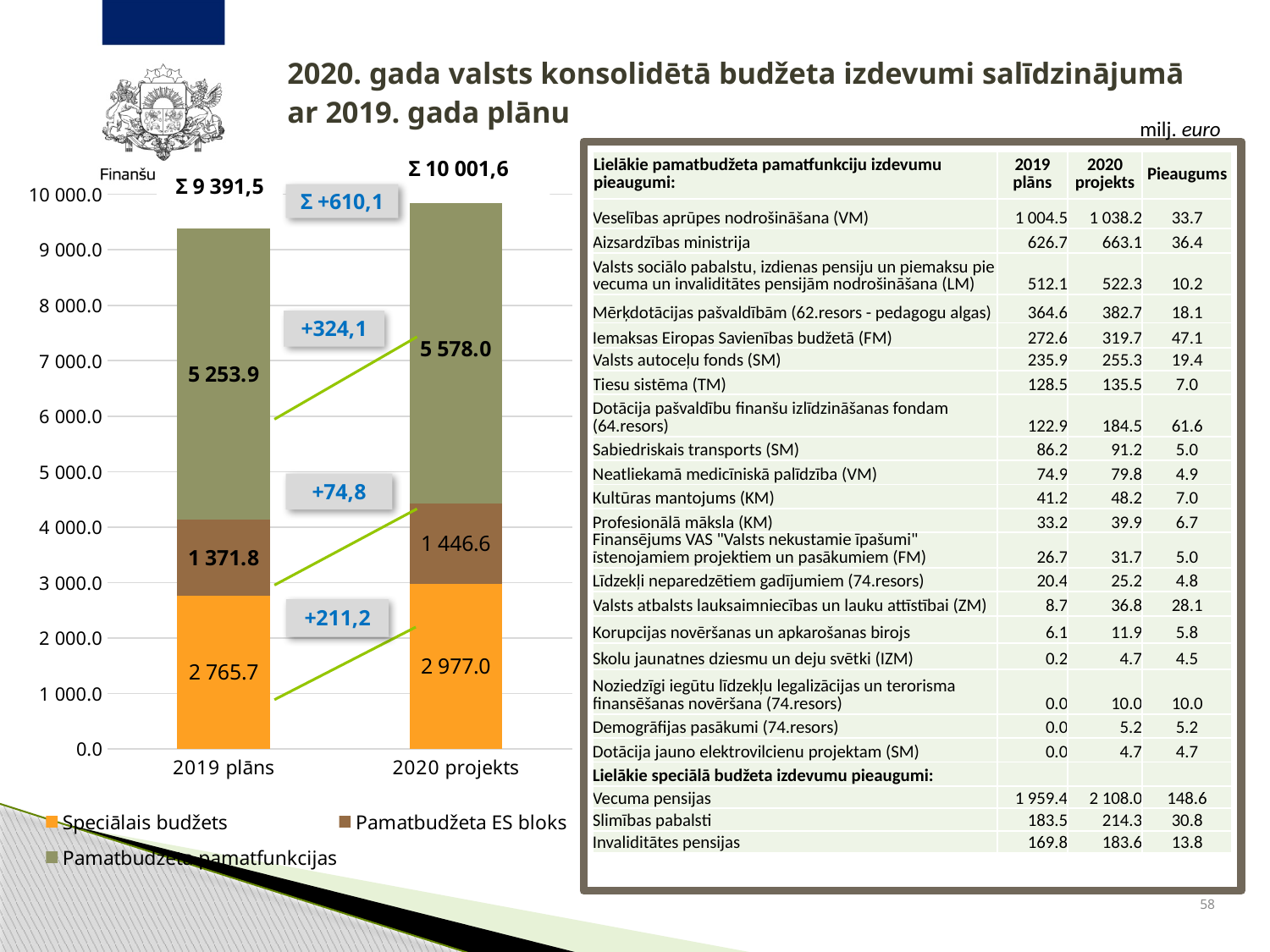
Which series has the largest value in the 2020 projekts bar? Pamatbudžeta pamatfunkcijas Which series is shown in orange in the chart? Speciālais budžets What is the value of Pamatbudžeta pamatfunkcijas for 2020 projekts? 5 578.0 By how much does Speciālais budžets increase from 2019 plāns to 2020 projekts? +211,2 How many series does the chart legend list? 3 What is the value of Pamatbudžeta ES bloks for 2019 plāns? 1 371.8 Which is larger: Pamatbudžeta ES bloks for 2019 plāns or for 2020 projekts? 2020 projekts What is the value of Speciālais budžets for 2019 plāns? 2 765.7 What type of chart is shown on the slide? stacked bar chart What is the total of the stacked bar for 2020 projekts? Σ 10 001,6 What is the total of the stacked bar for 2019 plāns? Σ 9 391,5 How many categories are shown on the x axis of the chart? 2